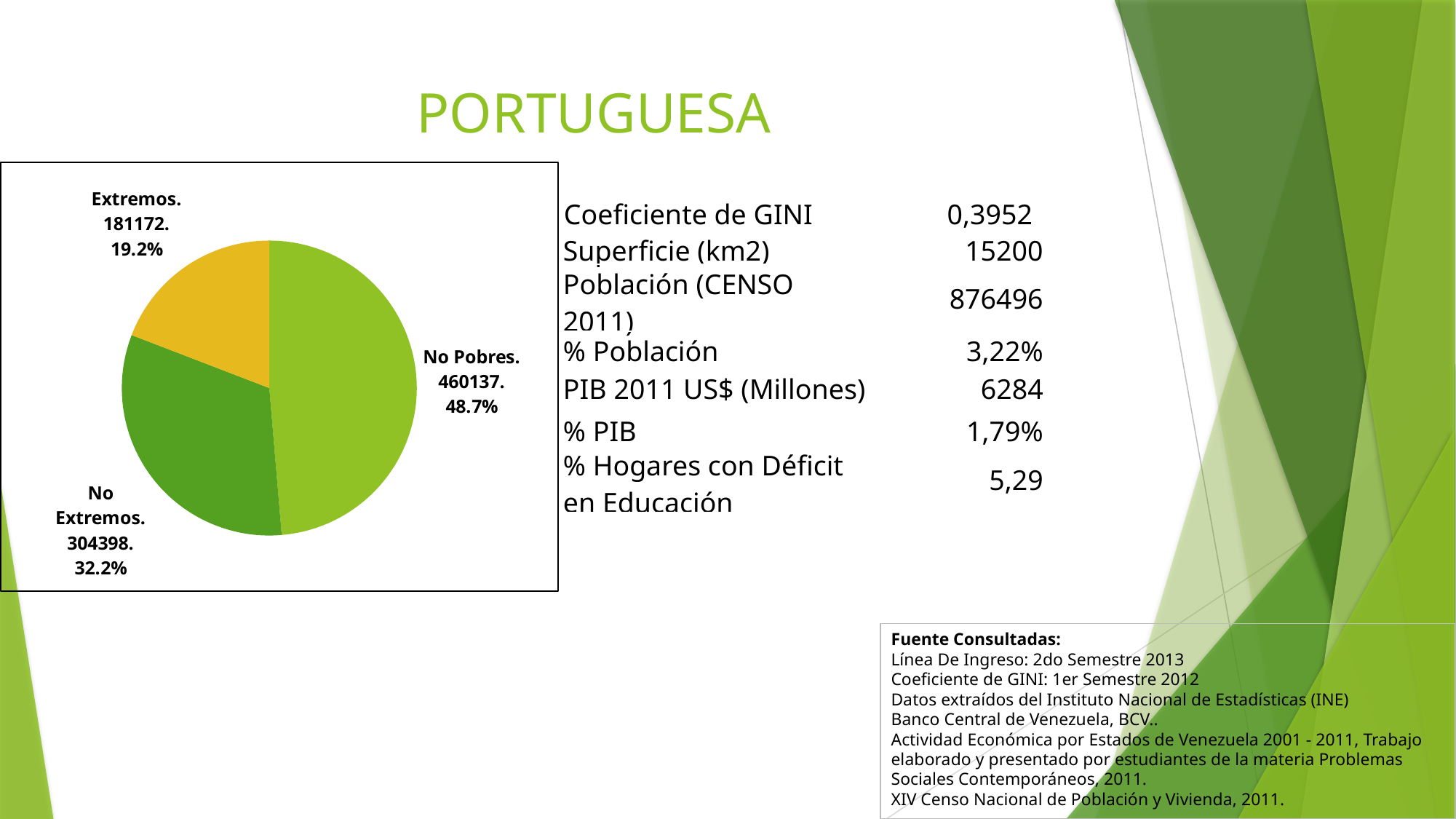
What kind of chart is shown on the slide? pie chart What is the value for No Pobres in the pie chart? 460137 How many slices does the pie chart have? 3 What colour is the Extremos slice of the pie chart? yellow What is the value for Extremos in the pie chart? 181172 Which slice of the pie chart is the smallest? Extremos What is the difference between the No Extremos value and the Extremos value? 123226 What percentage share does the Extremos slice have? 19.2% Which is larger, the No Pobres slice or the No Extremos slice? No Pobres What is the value for No Extremos in the pie chart? 304398 Which slice of the pie chart is the largest? No Pobres What percentage share does the No Extremos slice have? 32.2%